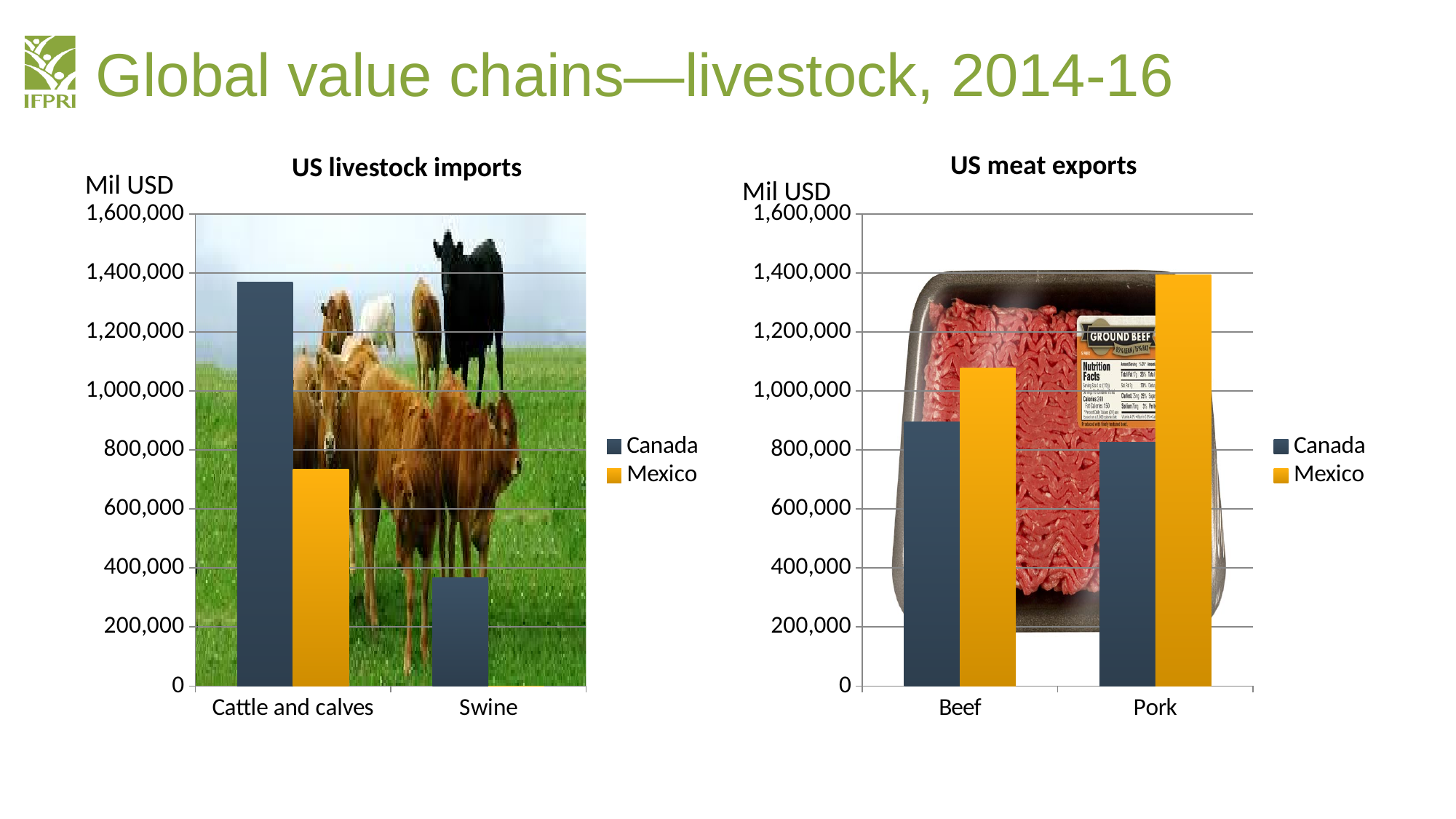
In the 'US livestock imports' chart, is the Mexico value for Cattle and calves greater or less than 800,000? less In the 'US meat exports' chart, is the Mexico value for Beef greater or less than 1,000,000? greater How many categories are shown on the x axis of the 'US meat exports' chart? 2 In the 'US livestock imports' chart, is the Canada value for Cattle and calves greater or less than 1,200,000? greater In the 'US livestock imports' chart, which is larger for Swine, Canada or Mexico? Canada What unit is shown on the vertical axis of the 'US meat exports' chart? Mil USD In the 'US meat exports' chart, which bar is the tallest? Mexico, Pork In the 'US livestock imports' chart, which bar is the tallest? Canada, Cattle and calves What kind of chart is the 'US livestock imports' chart? bar chart How many series does the legend of the 'US livestock imports' chart list? 2 In the 'US meat exports' chart, which is larger for Beef, Canada or Mexico? Mexico